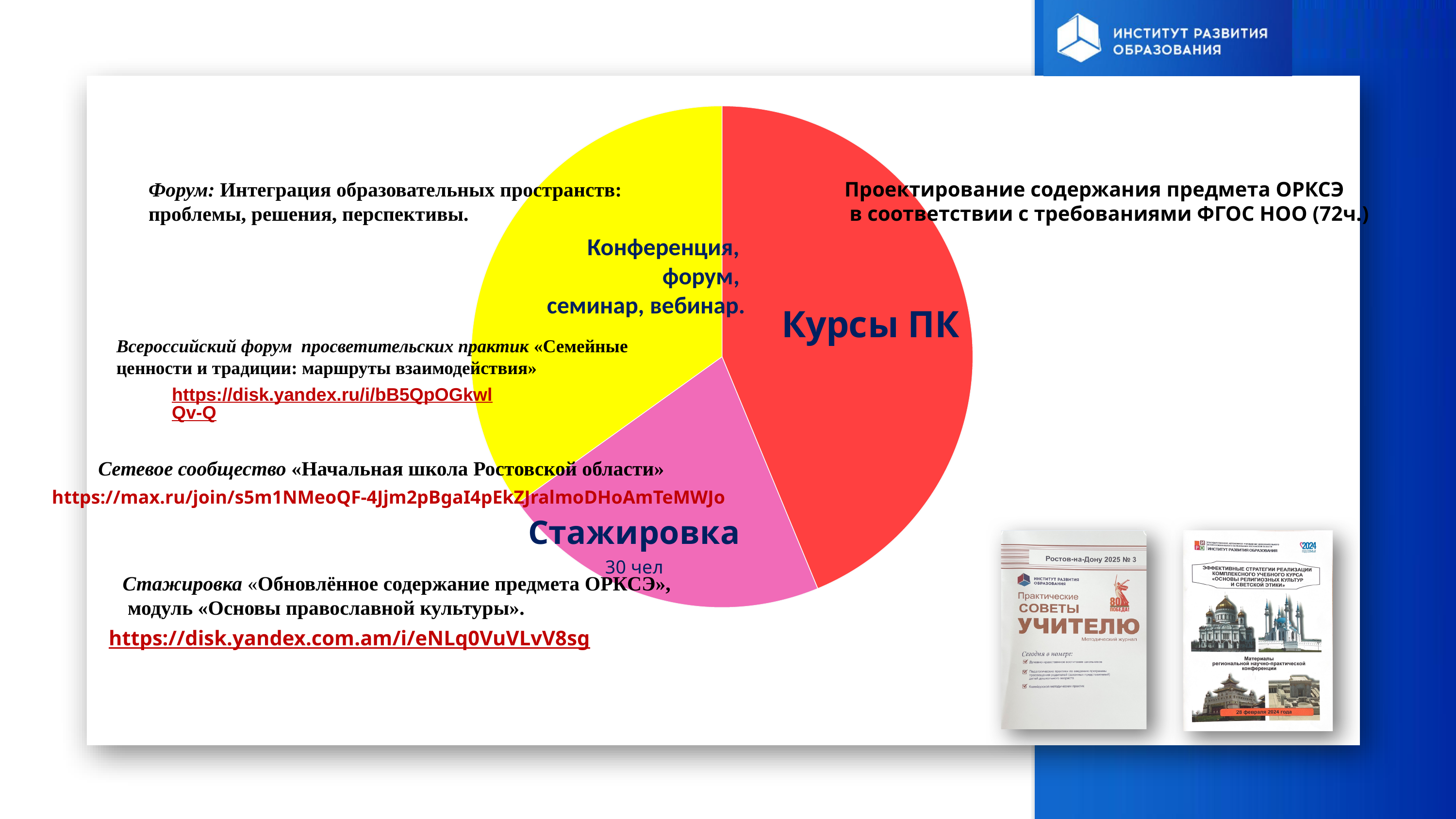
Which slice of the pie chart is the largest? Курсы ПК Which slice of the pie chart is the smallest? Стажировка What colour is the Стажировка slice of the pie chart? pink What colour is the Курсы ПК slice of the pie chart? red How many slices does the pie chart have? 3 What value is printed for the Стажировка slice? 30 чел What kind of chart is shown on the slide? pie chart Which slice is larger, Курсы ПК or Конференция, форум, семинар, вебинар? Курсы ПК Which slice is larger, Курсы ПК or Стажировка? Курсы ПК Which slice is larger, Стажировка or Конференция, форум, семинар, вебинар? Конференция, форум, семинар, вебинар